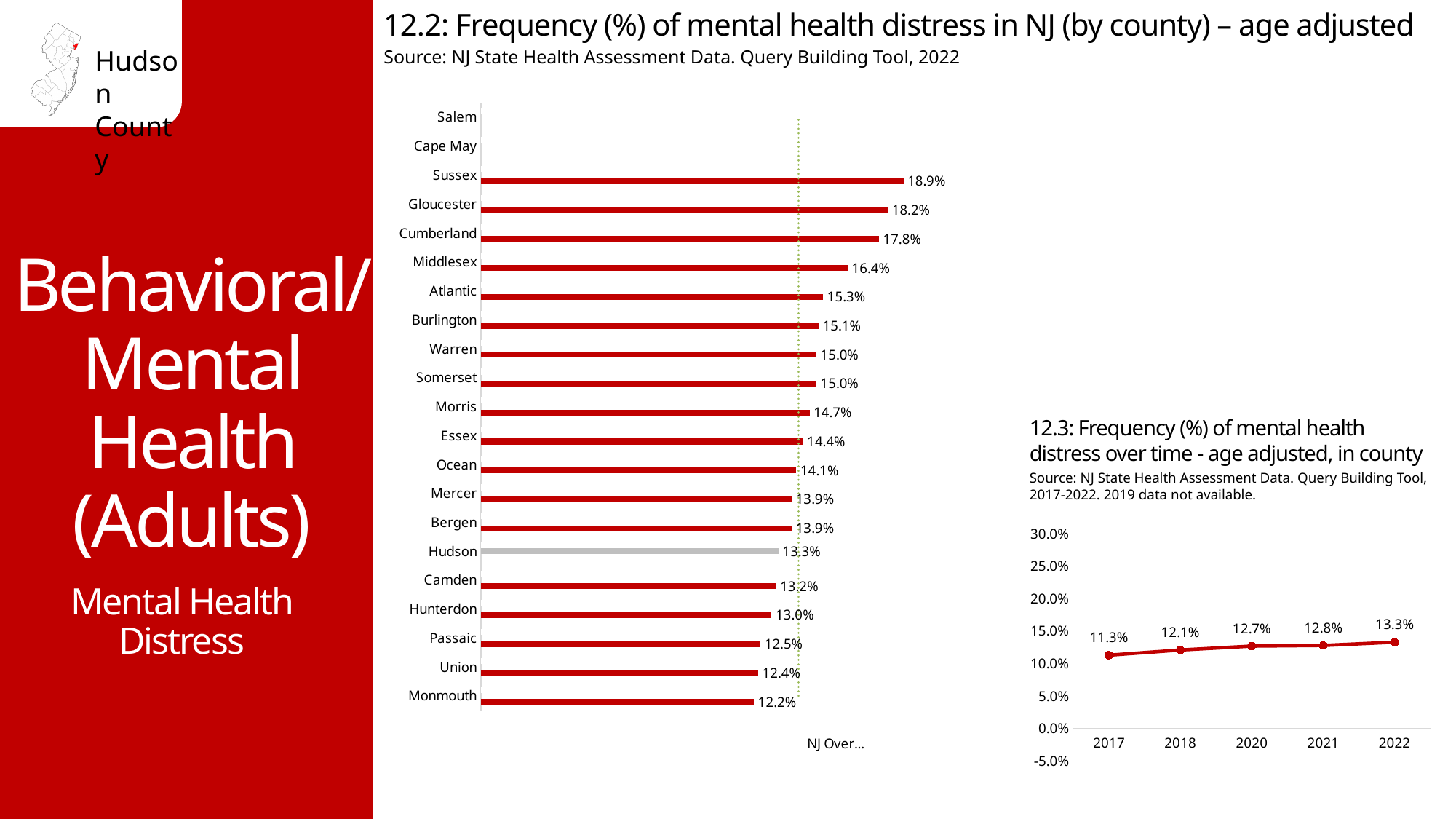
In chart 12.2, what is the difference between the values for Sussex and Hudson? 5.6% In chart 12.3, how many years are plotted? 5 In chart 12.3, do the values rise or fall from 2017 to 2022? Rise In chart 12.3, what is the difference between the values for 2022 and 2017? 2.0% In chart 12.2, what is the value for Cumberland? 17.8% In chart 12.2, which county has the lowest value among those with a bar? Monmouth In chart 12.2, which has a larger value, Middlesex or Atlantic? Middlesex In chart 12.3, what is the value for 2017? 11.3% In chart 12.2, what is the value for Hudson? 13.3% What kind of chart is chart 12.2? Bar chart In chart 12.2, what is the value for Sussex? 18.9% In chart 12.2, which county has the highest value among those with a bar? Sussex